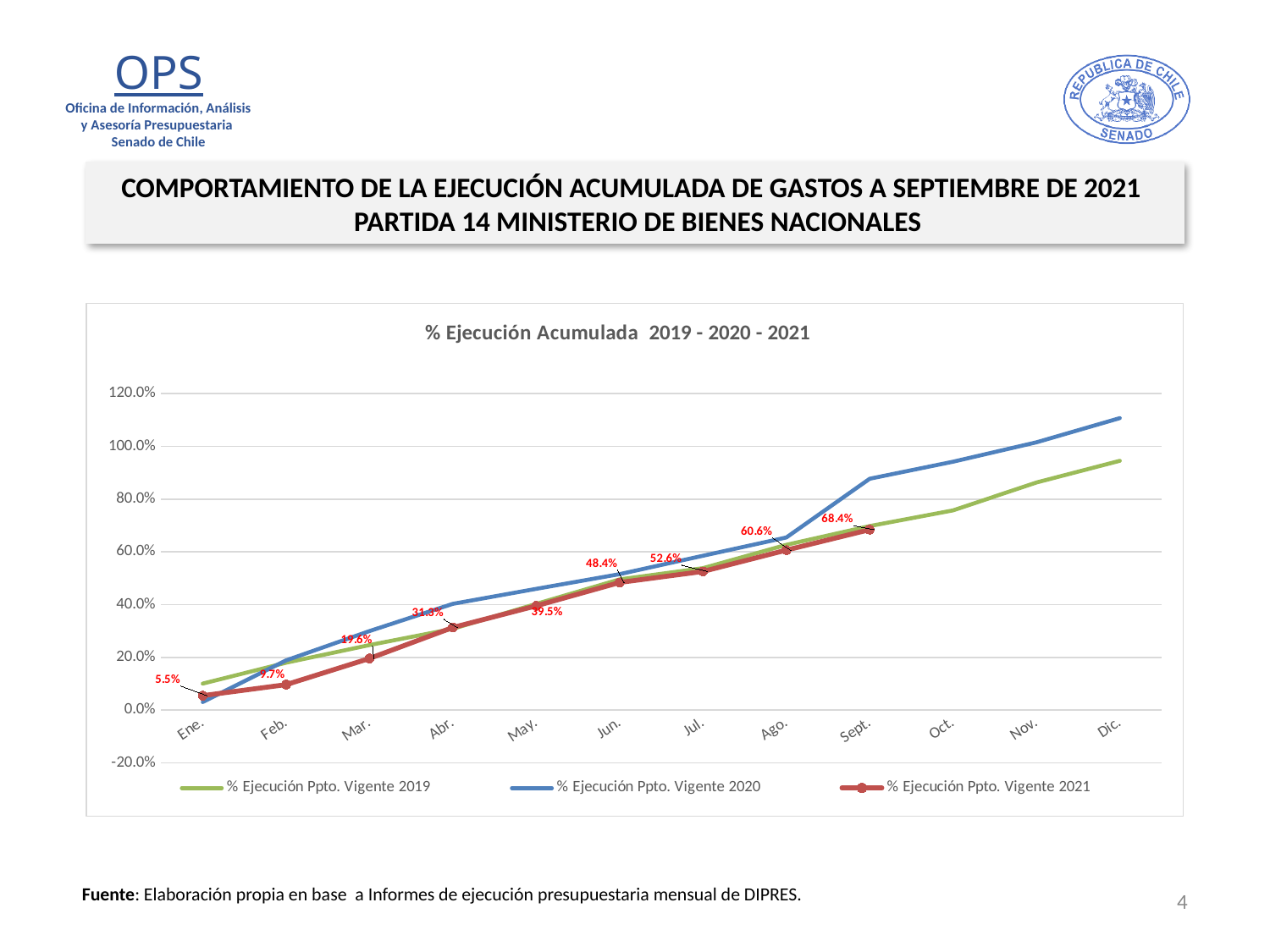
What is the value of % Ejecución Ppto. Vigente 2021 for Ene.? 5.5% Is the value for % Ejecución Ppto. Vigente 2019 in Dic. greater or less than 100.0%? less What is the value of % Ejecución Ppto. Vigente 2021 for Sept.? 68.4% What is the value of % Ejecución Ppto. Vigente 2021 for Jun.? 48.4% In Dic., which series has the higher value: 2019 or 2020? % Ejecución Ppto. Vigente 2020 How many months are shown along the x axis? 12 Is the value for % Ejecución Ppto. Vigente 2020 in Dic. greater or less than 100.0%? greater What kind of chart is shown on the slide? line chart How many series does the legend list? 3 What is the difference between the 2021 values for Sept. and Ago.? 7.8% Do the values of the 2021 series rise or fall from Ene. to Sept.? rise What is the value of % Ejecución Ppto. Vigente 2021 for Ago.? 60.6%